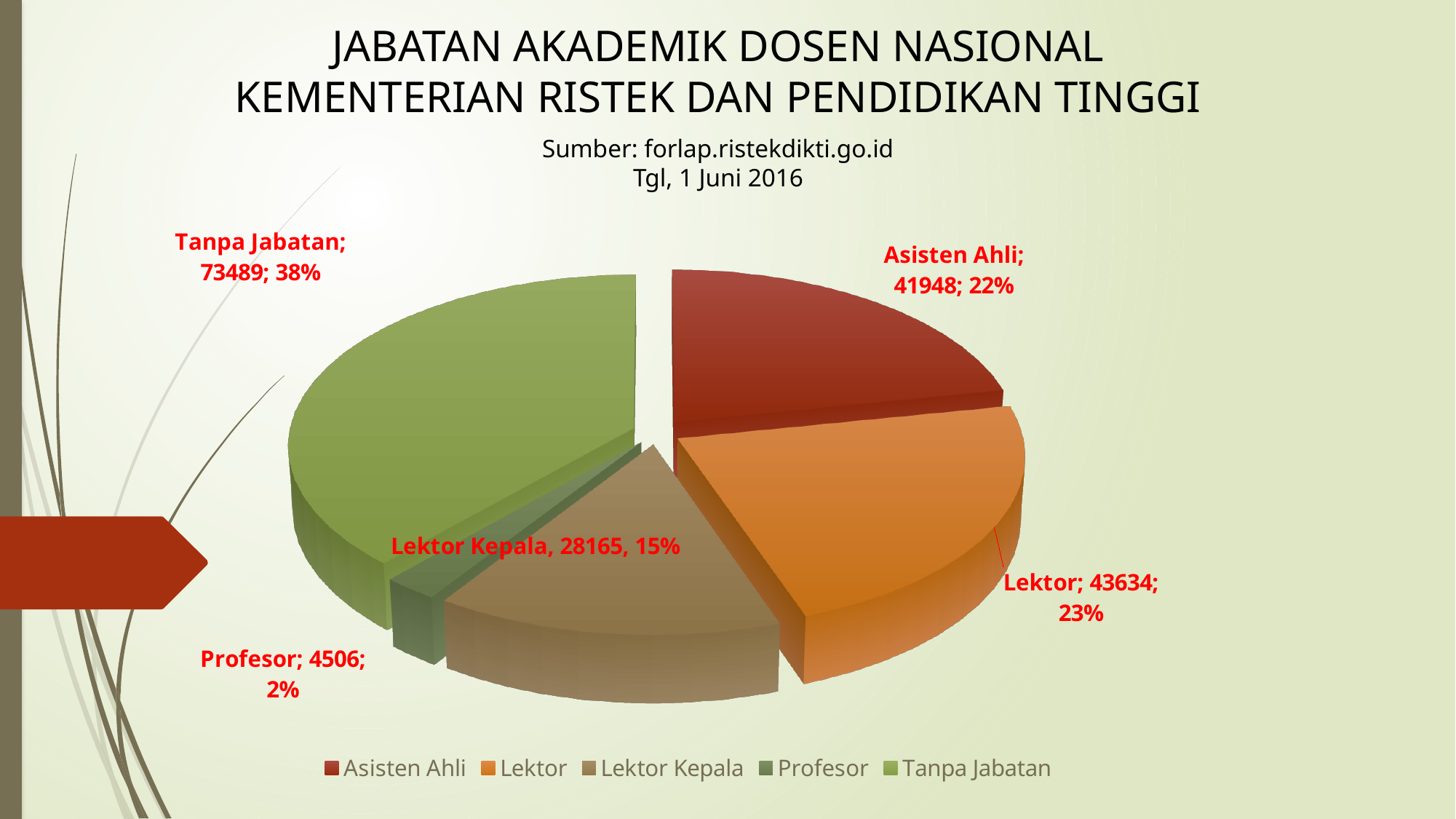
What is the value for Profesor? 4506 Which category has the largest slice? Tanpa Jabatan What share of the pie does Lektor represent? 23% Which is larger, the value for Lektor Kepala or the value for Asisten Ahli? Asisten Ahli What is the source cited below the chart title? forlap.ristekdikti.go.id What is the value for Lektor Kepala? 28165 Which category has the smallest slice? Profesor How many categories does the pie chart have? 5 What is the difference between the values for Tanpa Jabatan and Lektor? 29855 What kind of chart is shown on the slide? pie chart What is the value for Tanpa Jabatan? 73489 What share of the pie does Asisten Ahli represent? 22%